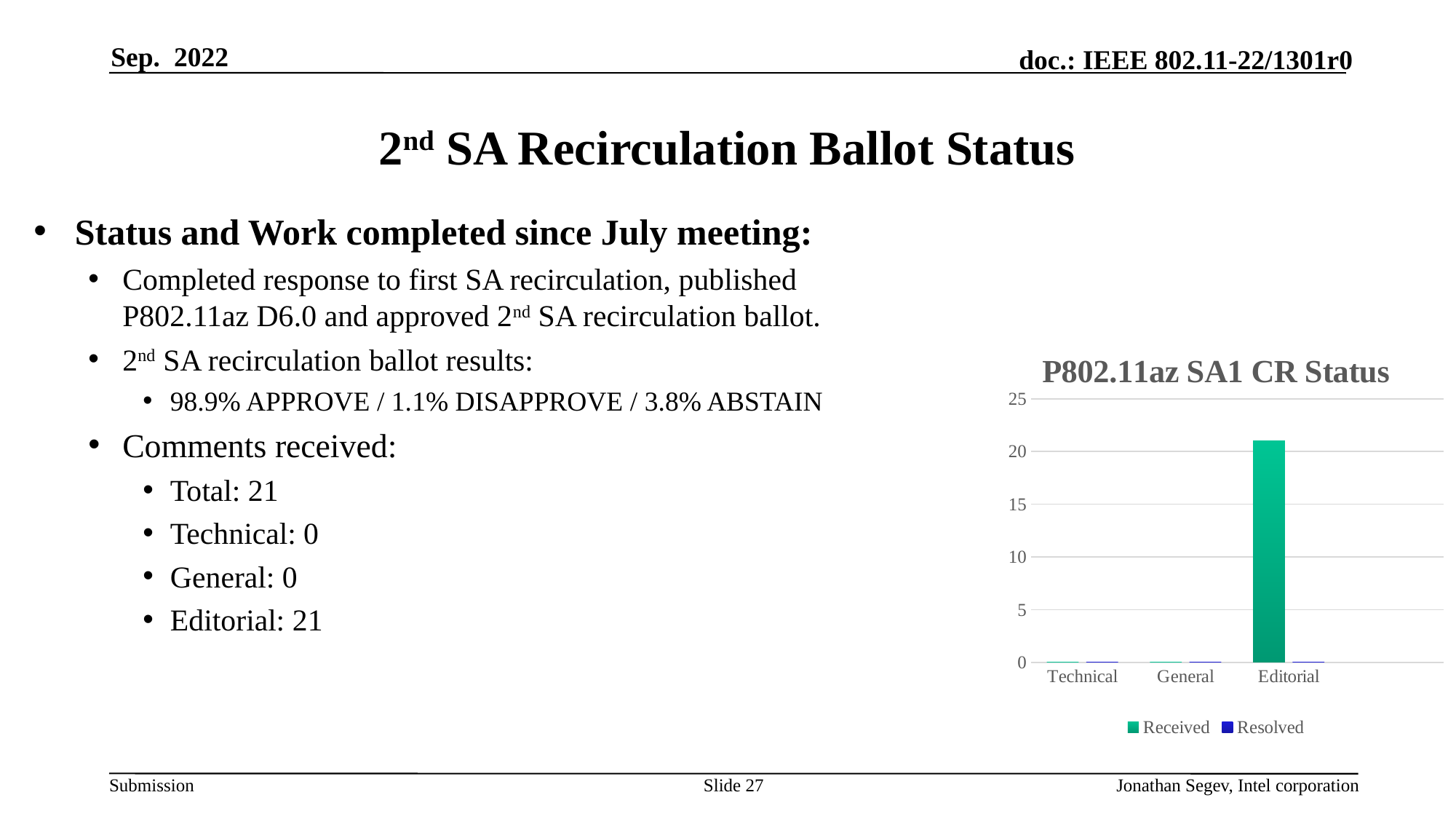
Which is larger in the chart, the Received value for Editorial or the Received value for Technical? Editorial Which series are listed in the chart legend? Received and Resolved What is the title of the chart on the slide? P802.11az SA1 CR Status Is the Received value for Editorial greater or less than 25? less What is the Received value for Technical in the chart? 0 What is the highest value shown on the chart's vertical axis? 25 Which category has the highest Received value in the chart? Editorial What kind of chart is shown on the slide? bar chart What is the Received value for General in the chart? 0 How many categories are shown on the x axis of the chart? 3 Is the Received value for Editorial greater or less than 20? greater How many series does the chart legend list? 2